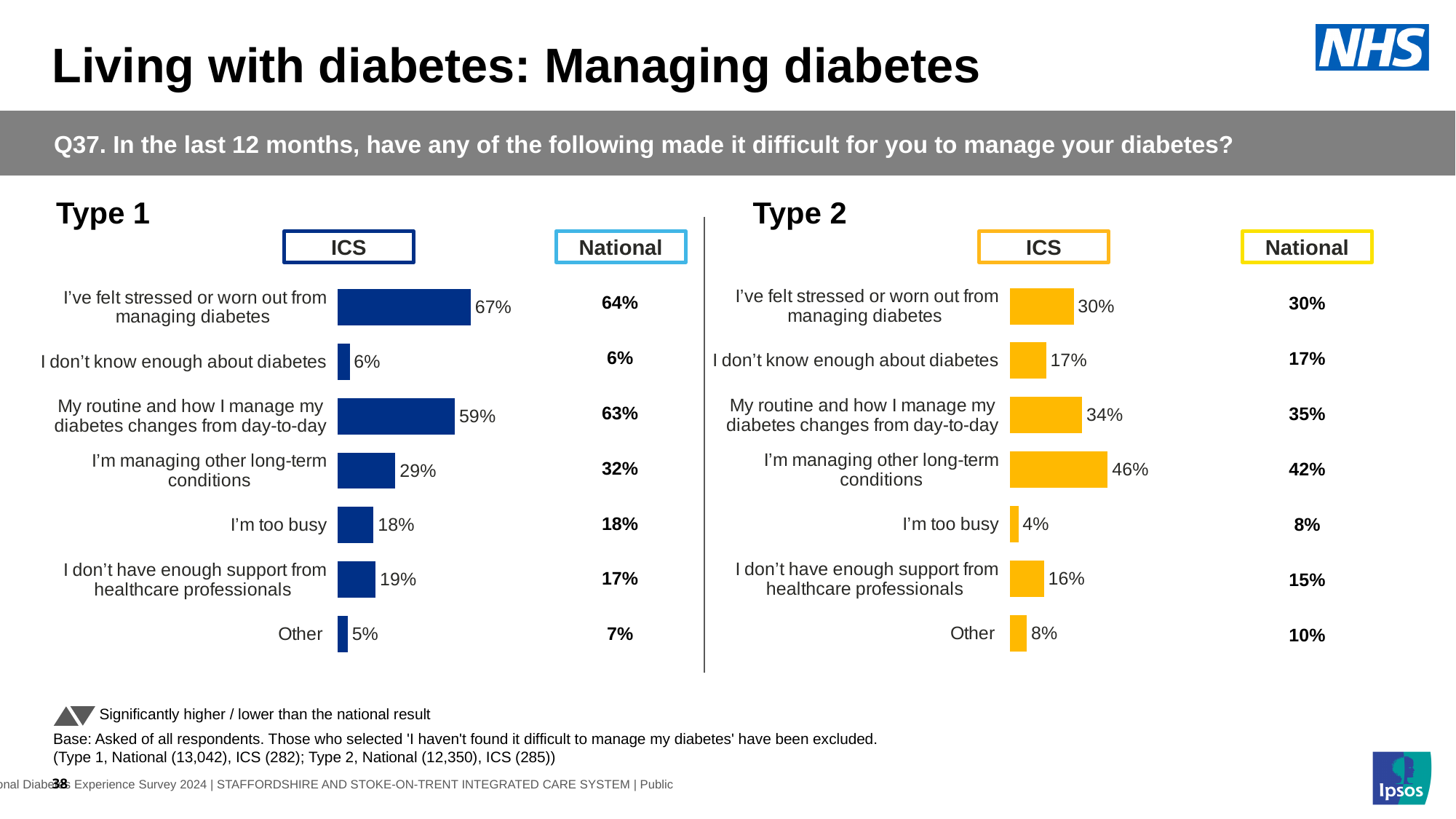
In the Type 2 chart, what is the ICS value for 'I'm managing other long-term conditions'? 46% In the Type 2 chart, what is the National value for 'I'm too busy'? 8% In the Type 1 chart, what is the National value for 'My routine and how I manage my diabetes changes from day-to-day'? 63% In the Type 1 chart, what is the difference between the ICS and National values for 'I've felt stressed or worn out from managing diabetes'? 3 percentage points In the Type 1 chart, is the ICS value for 'I'm too busy' larger or smaller than the ICS value for 'I don't have enough support from healthcare professionals'? smaller What colour are the bars in the Type 2 chart? yellow/orange In the Type 2 chart, what is the difference between the ICS and National values for 'I'm managing other long-term conditions'? 4 percentage points In the Type 1 chart, which category has the highest ICS value? I've felt stressed or worn out from managing diabetes In the Type 1 chart, what is the ICS value for 'I've felt stressed or worn out from managing diabetes'? 67% How many categories are shown in the Type 1 chart? 7 In the Type 2 chart, which category has the lowest ICS value? I'm too busy What type of chart is used for the Type 2 ICS results? bar chart